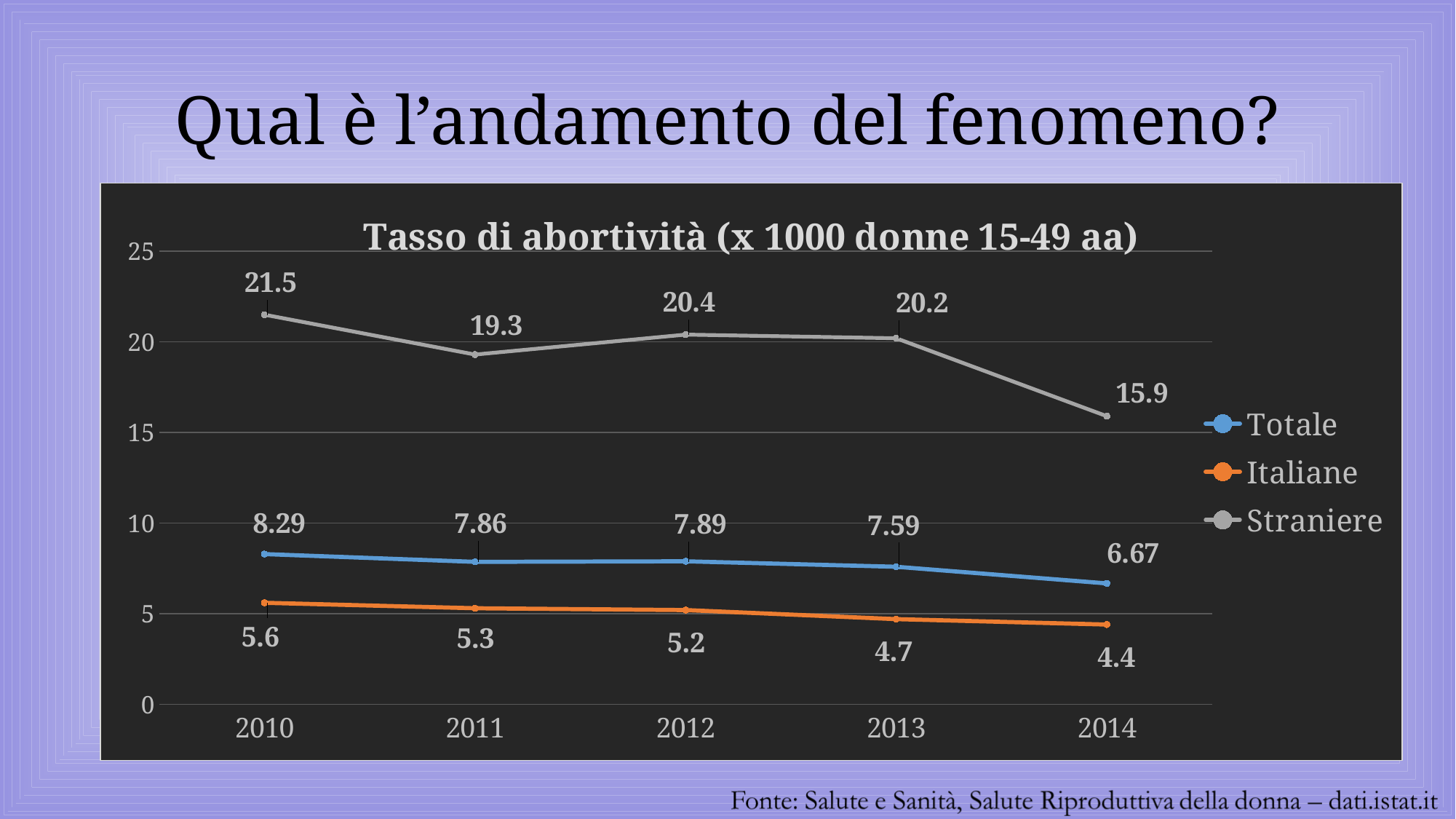
What kind of chart is shown? line chart How many years are shown on the x axis? 5 What is the value for Straniere in 2010? 21.5 In which year is the Straniere series highest? 2010 What is the value for Italiane in 2013? 4.7 In which year is the Italiane series lowest? 2014 What is the value for Totale in 2014? 6.67 How many series does the legend list? 3 Does the Italiane series rise or fall from 2010 to 2014? fall What is the difference between the Straniere values in 2013 and 2014? 4.3 Is the value for Straniere in 2014 greater or less than 15? greater Which is larger in 2012: the Straniere value or the Totale value? Straniere